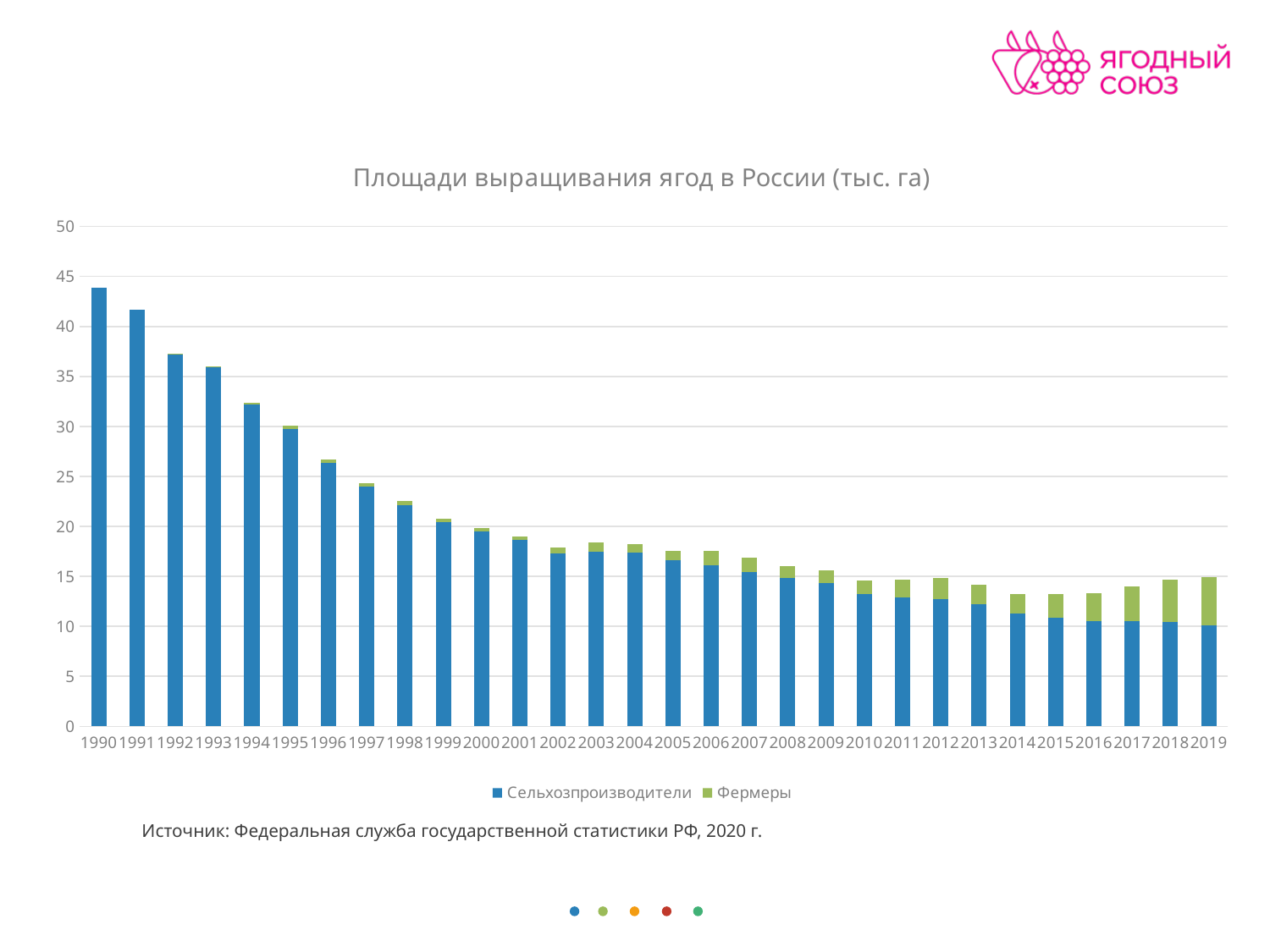
Is the total value for 2005 greater or less than 15? greater Which year has the highest total bar? 1990 How many series does the legend list? 2 Which two series are listed in the legend? Сельхозпроизводители and Фермеры What kind of chart is shown on the slide? Stacked bar chart Which is larger, the Фермеры value in 2019 or the Фермеры value in 1992? 2019 Which is larger, the total bar for 1990 or the total bar for 2019? 1990 Do the values for Сельхозпроизводители rise or fall from 1990 to 2019? Fall Is the value for Сельхозпроизводители in 2019 greater or less than 15? less Is the total value for 1990 greater or less than 40? greater How many years are shown on the x axis? 30 What is the title of the chart? Площади выращивания ягод в России (тыс. га)